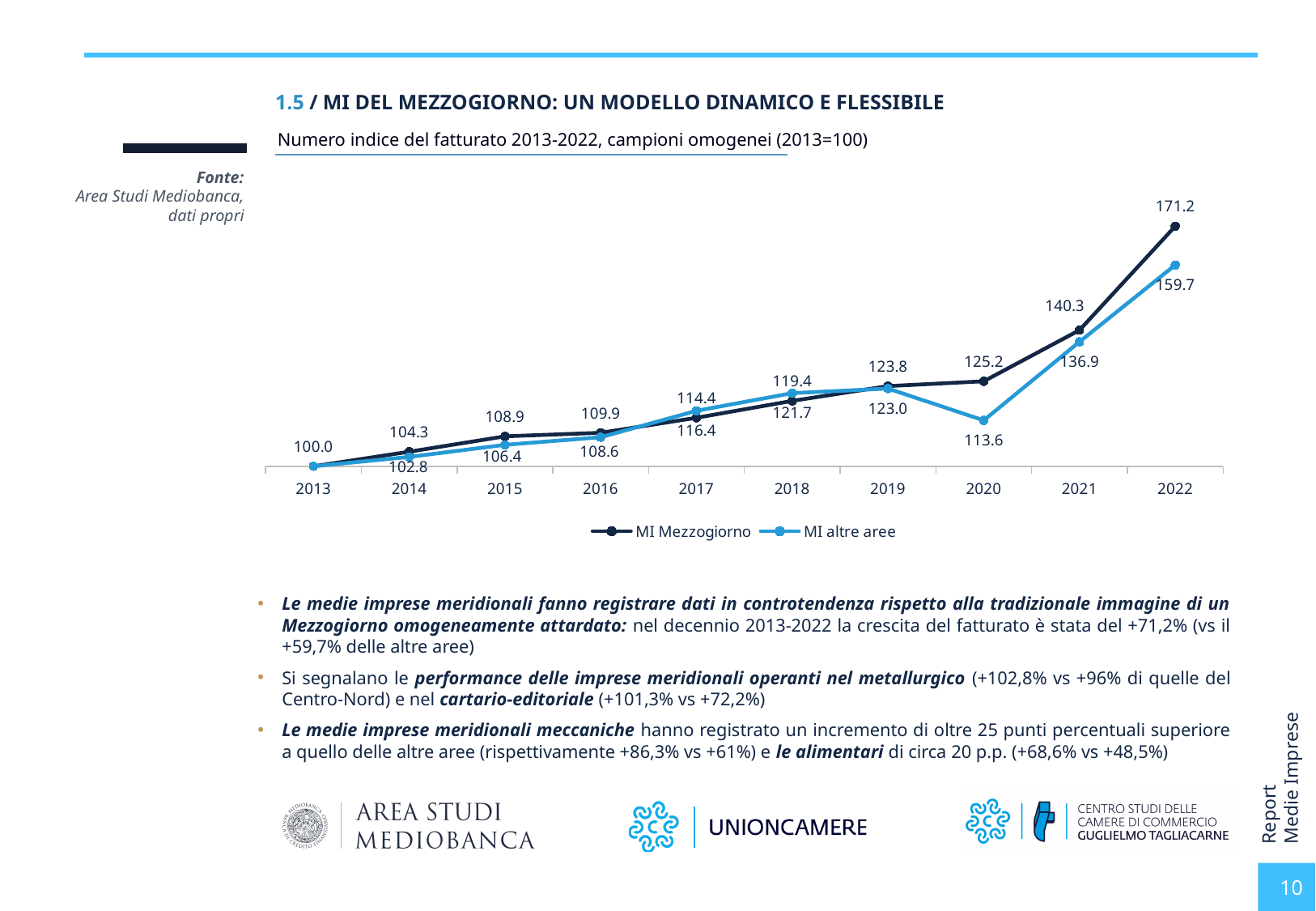
How many series does the legend list? 2 In 2020, which series has the higher value, MI Mezzogiorno or MI altre aree? MI Mezzogiorno What is the value for MI altre aree in 2020? 113.6 What is the value for MI Mezzogiorno in 2022? 171.2 In which year is the value for MI altre aree lowest? 2013 What is the value for MI altre aree in 2021? 136.9 What is the difference between MI Mezzogiorno and MI altre aree in 2022? 11.5 Does the MI Mezzogiorno series rise or fall from 2013 to 2022? Rise What is the value for MI Mezzogiorno in 2015? 108.9 In which year does MI Mezzogiorno reach its highest value? 2022 What kind of chart is shown on the slide? Line chart How many years are shown on the x axis? 10